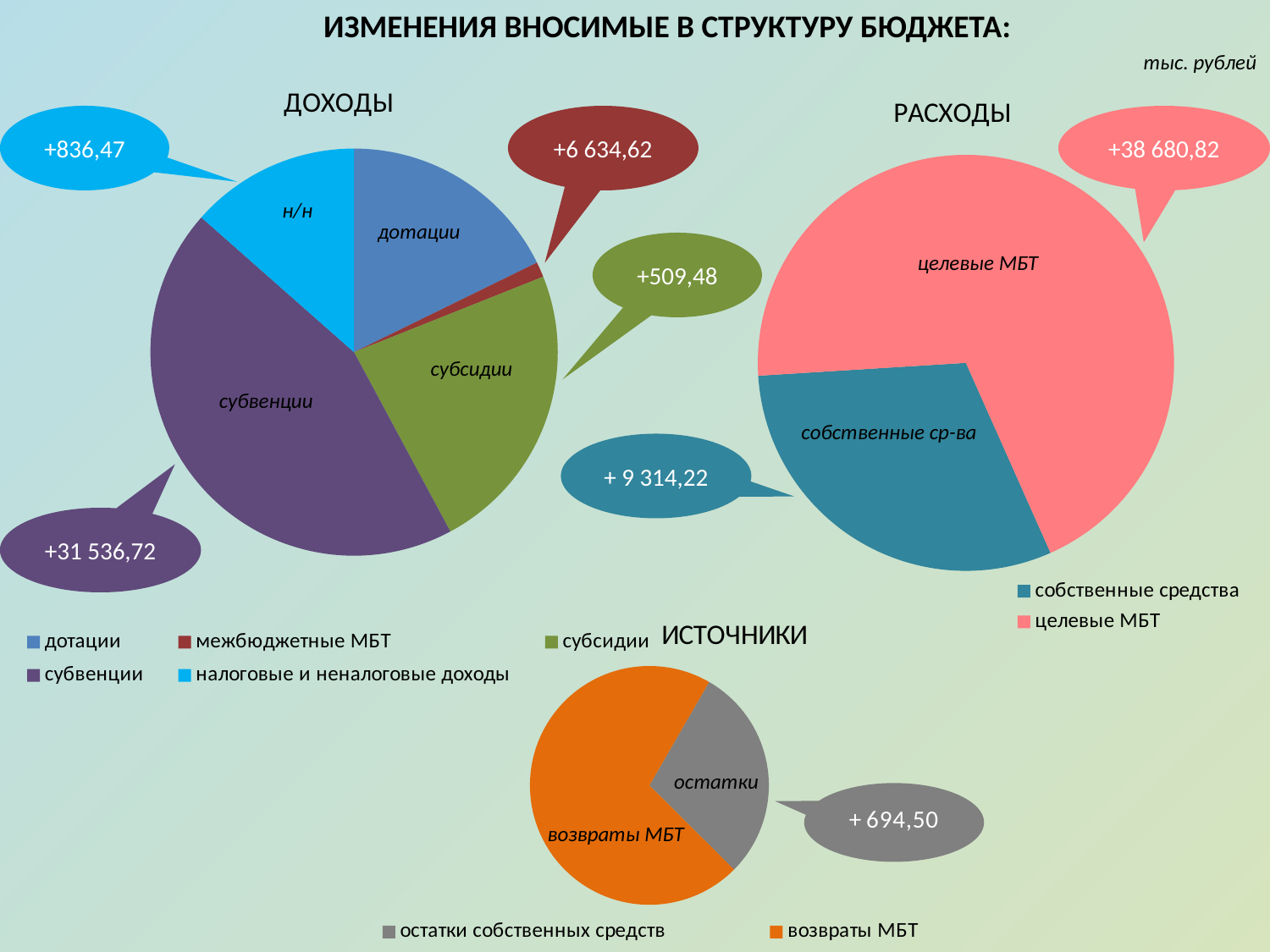
In the ДОХОДЫ chart, what change is shown in the callout pointing to the н/н slice? +836,47 In the РАСХОДЫ chart, how much larger is the change shown for целевые МБТ (+38 680,82) than the change shown for собственные ср-ва (+ 9 314,22)? 29 366,60 In the ДОХОДЫ chart, what change is shown in the callout for субсидии? +509,48 In the ИСТОЧНИКИ pie chart, which slice is the largest? возвраты МБТ In the ДОХОДЫ chart, what change is shown in the callout for субвенции? +31 536,72 What kind of chart is the ДОХОДЫ chart? pie chart In the ДОХОДЫ pie chart, which slice is the smallest? межбюджетные МБТ How many slices does the ДОХОДЫ pie chart have? 5 In the РАСХОДЫ pie chart, which slice is larger: целевые МБТ or собственные ср-ва? целевые МБТ In what units are the values on the slide given, according to the note at the top right? тыс. рублей In the РАСХОДЫ chart, what change is shown in the callout for целевые МБТ? +38 680,82 In the ДОХОДЫ pie chart, which slice is the largest? субвенции